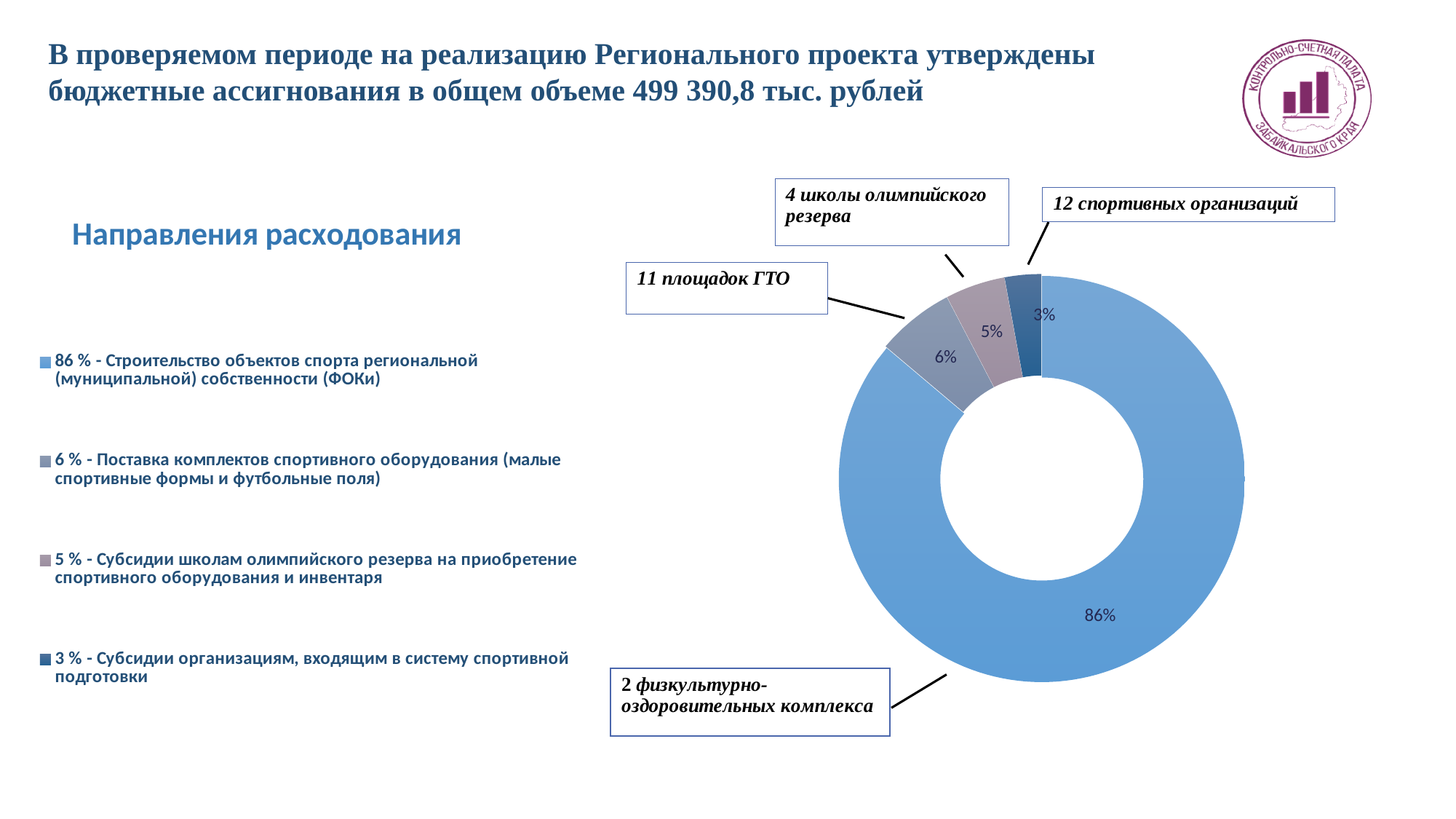
According to the callout on the chart, how many 'площадок ГТО' are associated with the 6% slice? 11 Which is larger: the slice for 'Субсидии школам олимпийского резерва' or the slice for 'Субсидии организациям, входящим в систему спортивной подготовки'? Субсидии школам олимпийского резерва What share of the chart is taken by 'Субсидии организациям, входящим в систему спортивной подготовки'? 3% What is the heading shown to the left of the chart? Направления расходования What share of the chart is taken by 'Поставка комплектов спортивного оборудования (малые спортивные формы и футбольные поля)'? 6% What kind of chart is shown on the slide? Doughnut (pie) chart What is the difference in percentage points between the largest slice (86%) and the slice for 'Поставка комплектов спортивного оборудования' (6%)? 80 percentage points How many slices does the doughnut chart have? 4 Which category has the smallest slice in the chart? Субсидии организациям, входящим в систему спортивной подготовки What share of the chart is taken by 'Субсидии школам олимпийского резерва на приобретение спортивного оборудования и инвентаря'? 5% Which category has the largest slice in the chart? Строительство объектов спорта региональной (муниципальной) собственности (ФОКи)